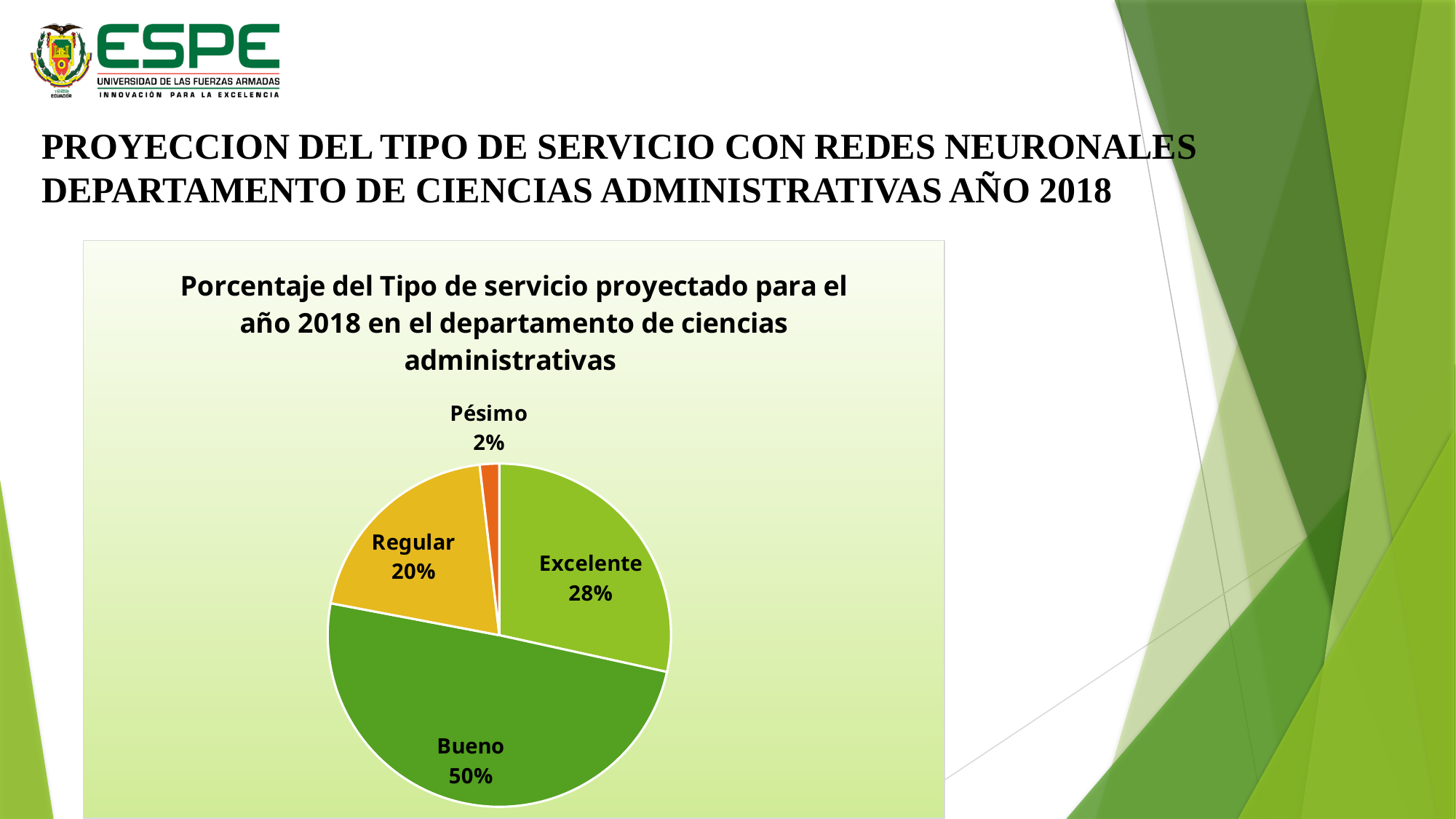
Which category has the largest share of the pie? Bueno What colour is the Pésimo slice? Orange What is the difference in percentage points between Bueno and Excelente? 22 What percentage is shown for Excelente? 28% Which is larger, the share for Excelente or the share for Regular? Excelente What percentage is shown for Regular? 20% What percentage is shown for Bueno? 50% What percentage is shown for Pésimo? 2% What is the title of the chart? Porcentaje del Tipo de servicio proyectado para el año 2018 en el departamento de ciencias administrativas Which category has the smallest share of the pie? Pésimo What kind of chart is shown on the slide? Pie chart How many categories are shown in the pie chart? 4